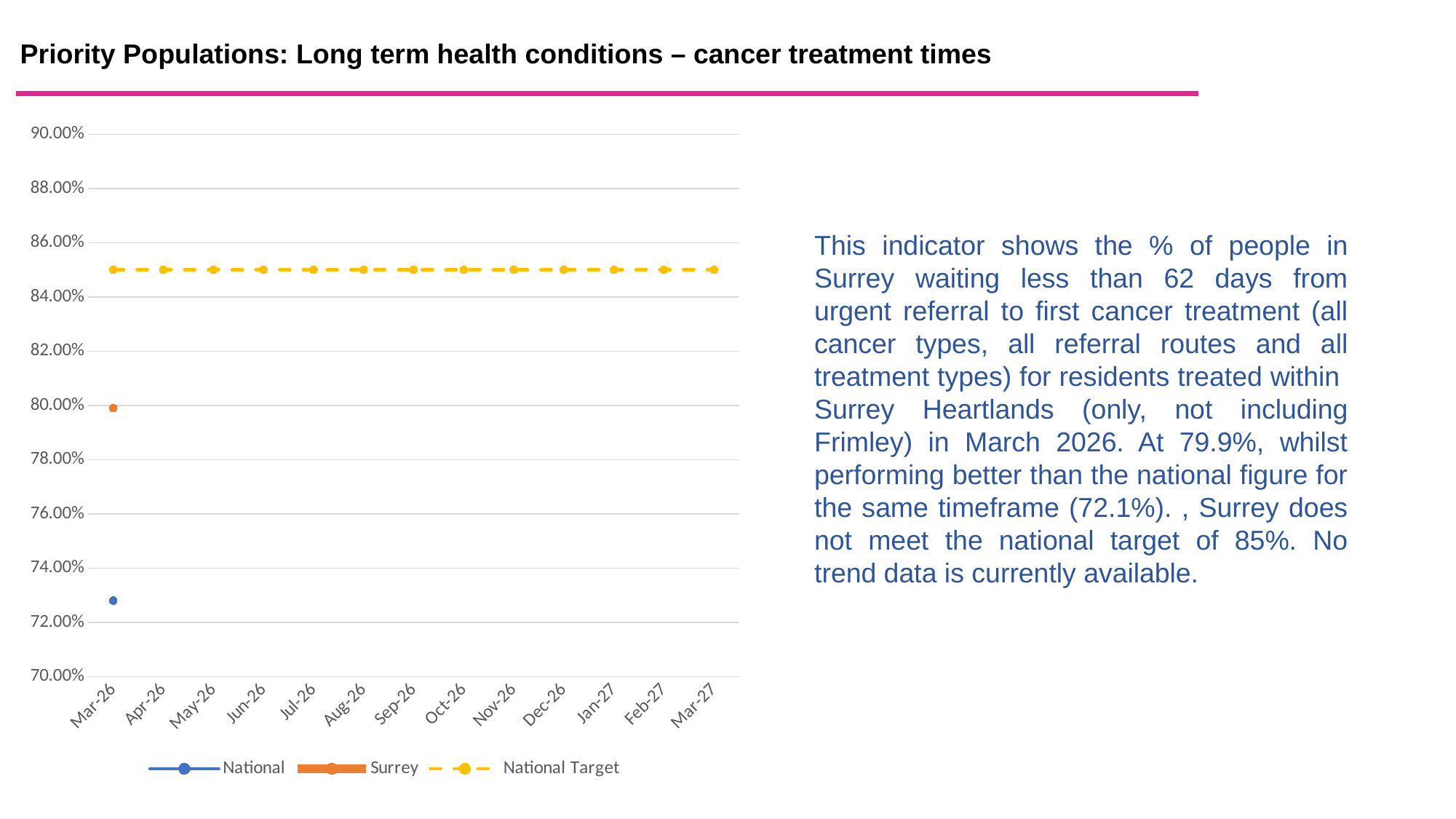
How many months are shown along the x axis of the chart? 13 Is the National value at Mar-26 greater or less than 74.00%? less Is the National Target line greater or less than 84.00%? greater Does the National Target line rise, fall or stay flat from Mar-26 to Mar-27? stays flat What kind of chart is shown on the slide? line chart How many series does the chart legend list? 3 What are the three entries in the chart legend? National, Surrey, National Target What colour is used for the Surrey series in the chart? orange At Mar-26, which is larger: the Surrey value or the National value? Surrey Which series has the highest value at Mar-26? National Target Is the Surrey value at Mar-26 greater or less than 78.00%? greater Which series has the lowest value at Mar-26? National